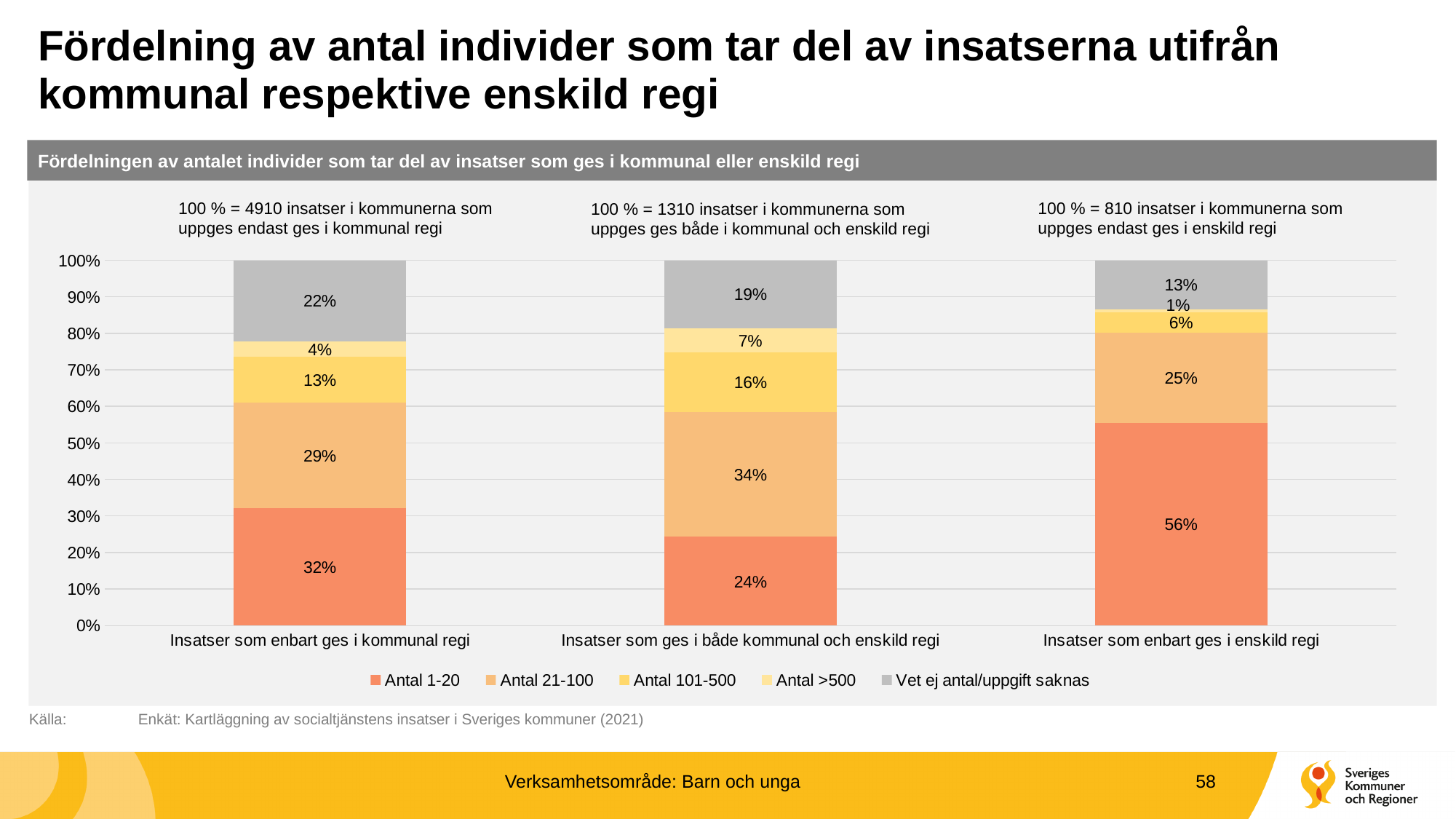
Which category has the lowest 'Antal 101-500' share? Insatser som enbart ges i enskild regi What is the 'Vet ej antal/uppgift saknas' share for 'Insatser som enbart ges i enskild regi'? 13% What is the 'Antal >500' share for 'Insatser som enbart ges i enskild regi'? 1% Which category has the highest 'Antal 1-20' share? Insatser som enbart ges i enskild regi Which is larger: the 'Vet ej antal/uppgift saknas' share for 'Insatser som enbart ges i kommunal regi' or for 'Insatser som ges i både kommunal och enskild regi'? Insatser som enbart ges i kommunal regi What is the 'Antal 21-100' share for 'Insatser som ges i både kommunal och enskild regi'? 34% What is the difference in the 'Antal 1-20' share between 'Insatser som enbart ges i enskild regi' and 'Insatser som enbart ges i kommunal regi'? 24 percentage points How many categories are shown on the x axis? 3 According to the note above the chart, how many insatser does 100% represent for 'Insatser som enbart ges i kommunal regi'? 4910 What share of 'Insatser som enbart ges i kommunal regi' falls in the 'Antal 1-20' category? 32% How many series does the legend list? 5 What kind of chart is shown on the slide? Stacked bar chart